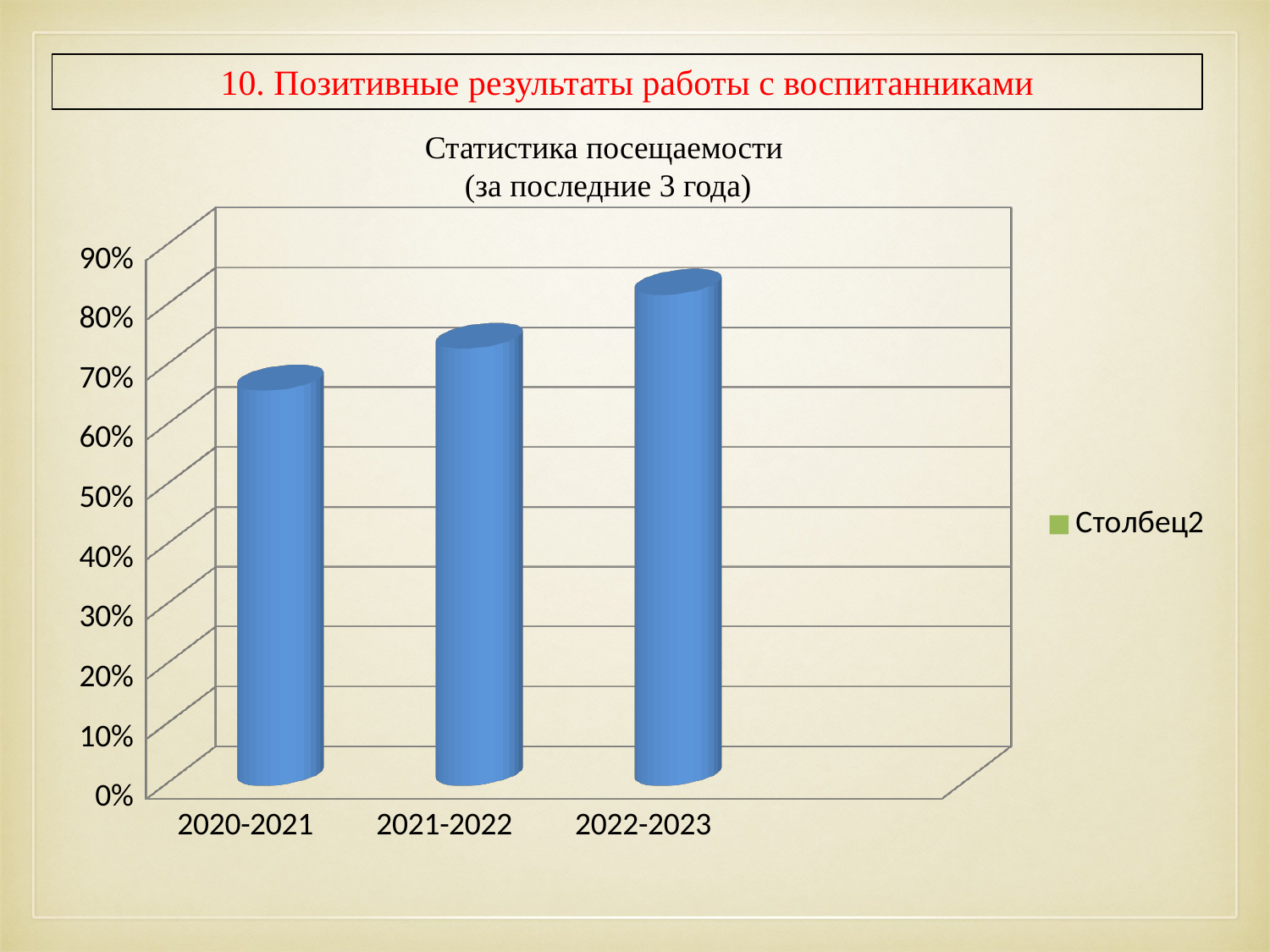
Which is larger: the value for 2020-2021 or the value for 2022-2023? 2022-2023 How many categories (year periods) are shown on the x axis of the chart? 3 Which year period has the highest attendance value in the chart? 2022-2023 What is the title of the chart? Статистика посещаемости (за последние 3 года) What kind of chart is shown on the slide? Bar chart How many series does the chart legend list? 1 Is the value for 2020-2021 greater or less than 60%? greater What is the name of the series shown in the chart legend? Столбец2 Is the value for 2022-2023 greater or less than 80%? greater Which year period has the lowest attendance value in the chart? 2020-2021 Is the value for 2021-2022 greater or less than 80%? less Do the values rise or fall from 2020-2021 to 2022-2023? Rise